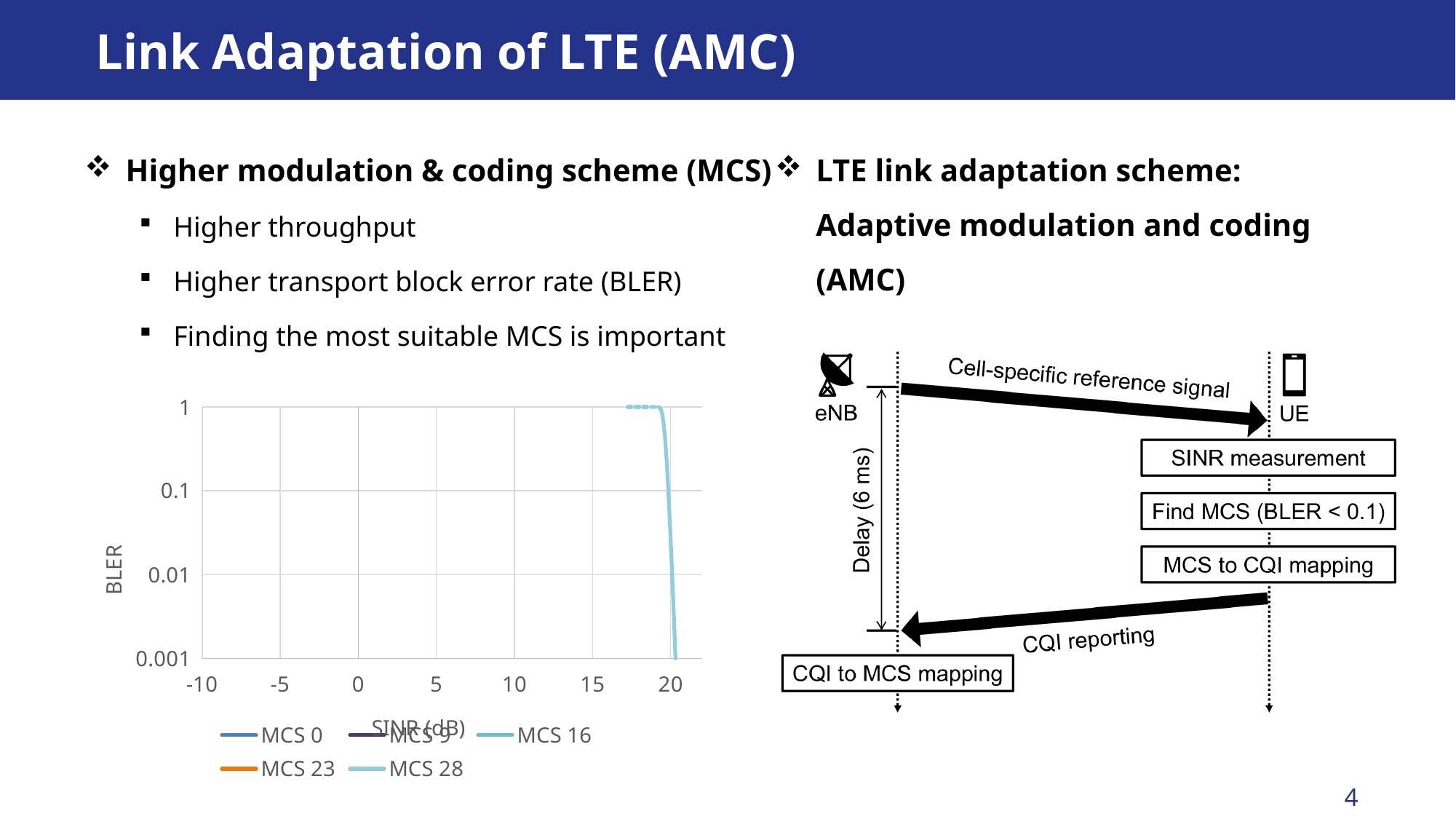
In the BLER chart, is the BLER for MCS 28 at an SINR of 18 dB greater or less than 0.01? greater In the BLER chart, is the BLER for MCS 28 at an SINR of 18 dB greater or less than 0.1? greater How many series does the legend of the BLER chart list? 5 In the BLER chart, does the visible MCS 28 curve rise or fall as SINR increases from 17 dB to 20 dB? fall Which series are listed in the legend of the BLER chart? MCS 0, MCS 9, MCS 16, MCS 23, MCS 28 What is the label of the y axis of the chart on the left? BLER What kind of chart is shown on the left of the slide? line chart